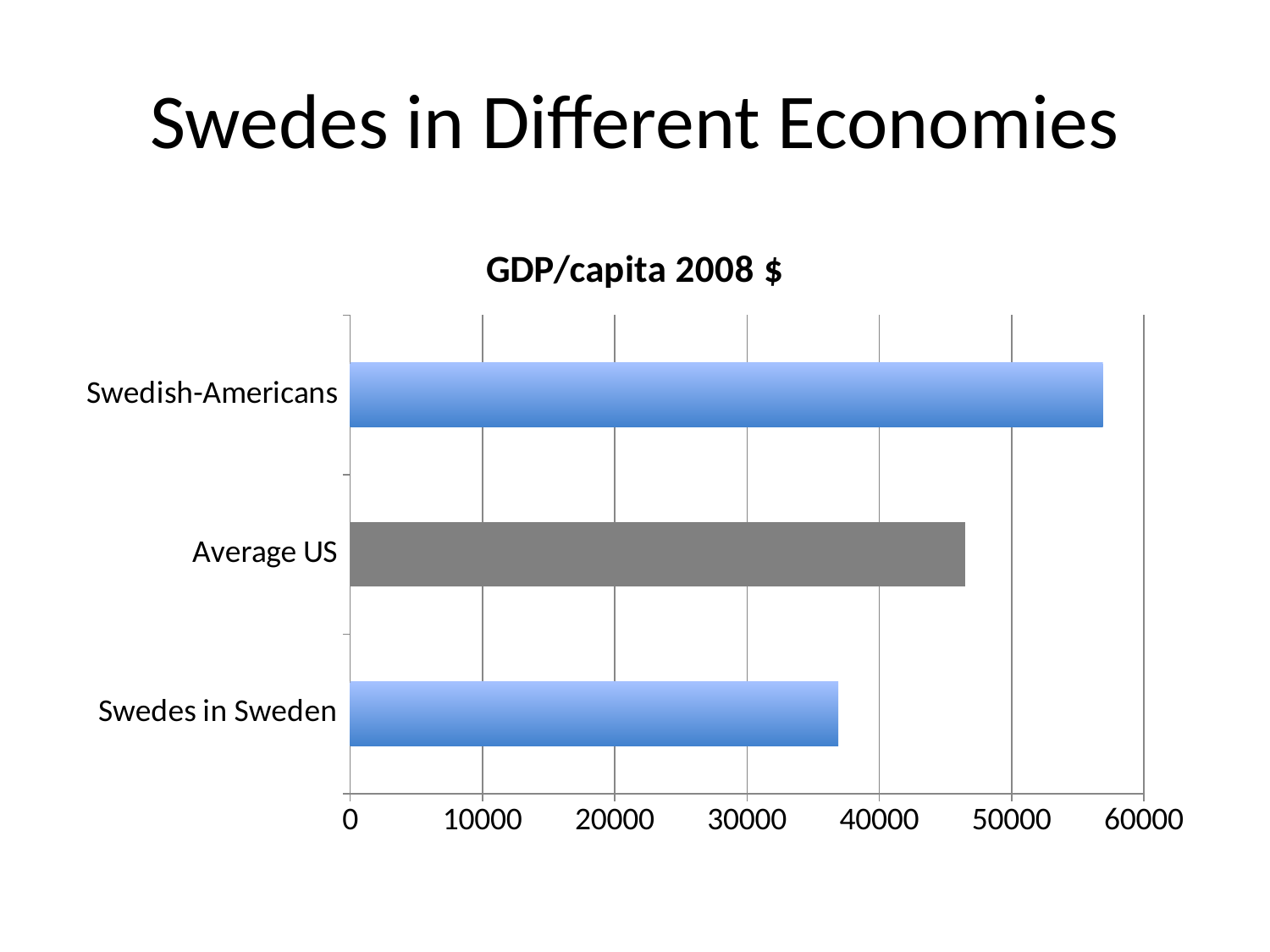
Is the value for Swedish-Americans greater or less than 50000? greater What kind of chart is shown on the slide? bar chart What is the maximum value shown on the horizontal axis? 60000 Which category has the highest GDP/capita? Swedish-Americans How many categories are plotted in the chart? 3 Is the value for Swedes in Sweden greater or less than 40000? less Which is larger, the value for Swedish-Americans or the value for Average US? Swedish-Americans Which category has the lowest GDP/capita? Swedes in Sweden What is the title of the chart? GDP/capita 2008 $ Which is larger, the value for Average US or the value for Swedes in Sweden? Average US Is the value for Average US greater or less than 40000? greater